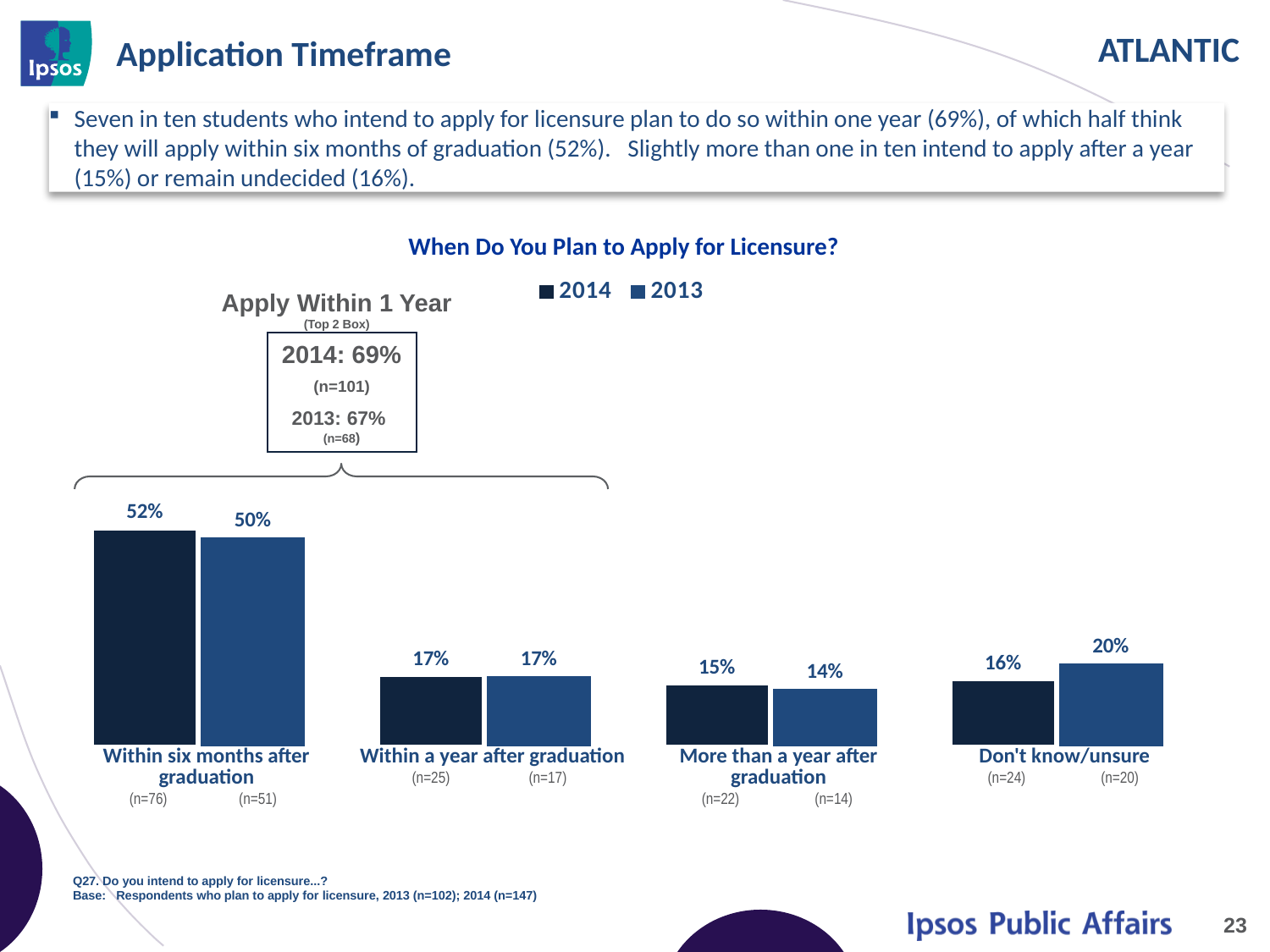
What is the title of the chart? When Do You Plan to Apply for Licensure? How many categories are shown on the x axis? 4 Which category has the highest 2014 value? Within six months after graduation Which is larger: the 2014 value for 'Within six months after graduation' or the 2013 value for the same category? 2014 What is the 2013 value for 'More than a year after graduation'? 14% What is the 2013 value for 'Don't know/unsure'? 20% What is the difference between the 2014 and 2013 values for 'Don't know/unsure'? 4% What is the difference between the 2014 values for 'Within six months after graduation' and 'Within a year after graduation'? 35% What kind of chart is shown? Bar chart How many series does the legend list? 2 What is the 2014 value for 'Within six months after graduation'? 52% Which category has the lowest 2013 value? More than a year after graduation